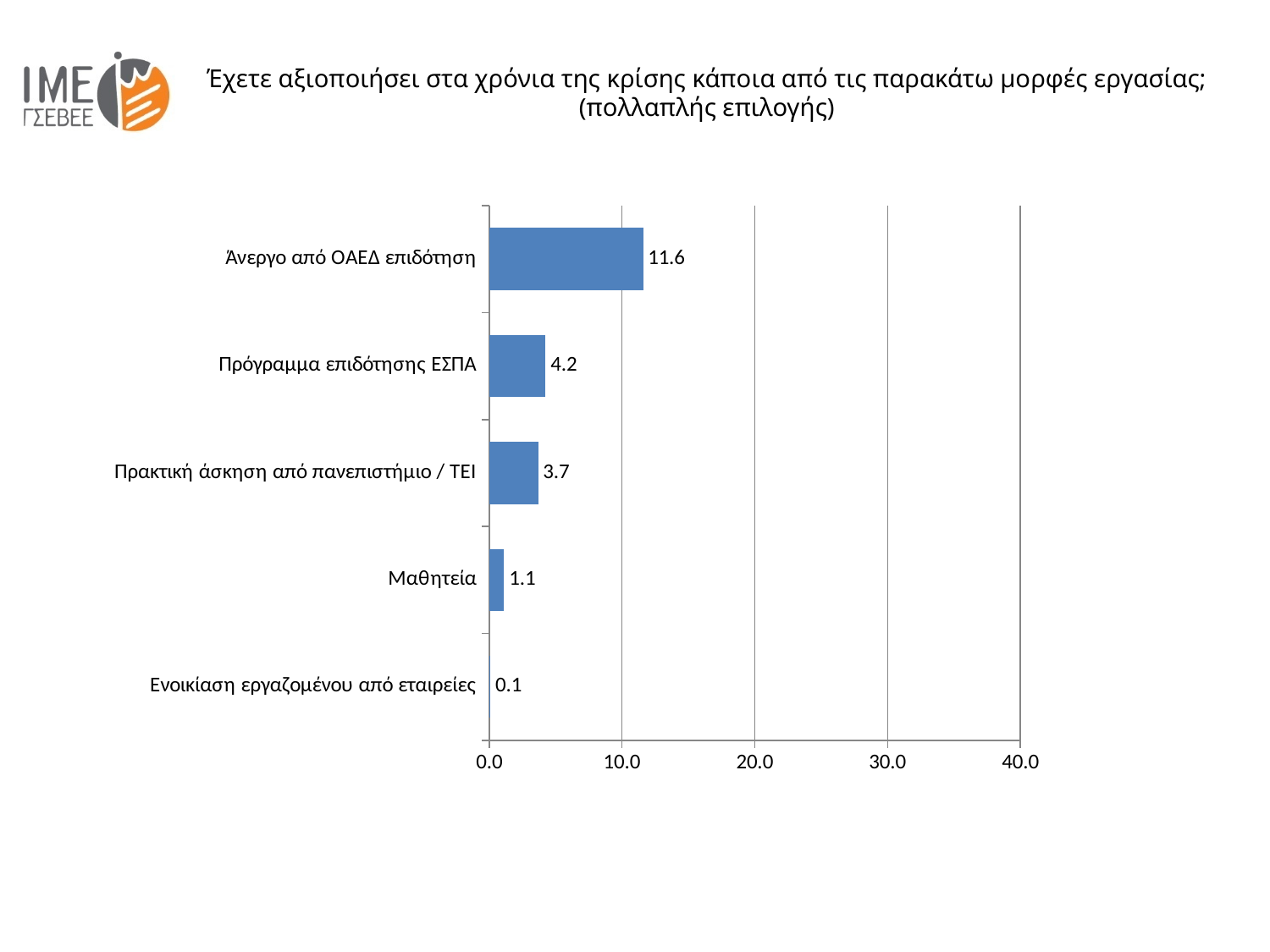
What is the value for Μαθητεία? 1.1 What is the difference between the values for Άνεργο από ΟΑΕΔ επιδότηση and Πρόγραμμα επιδότησης ΕΣΠΑ? 7.4 How many categories are shown in the chart? 5 What is the value for Άνεργο από ΟΑΕΔ επιδότηση? 11.6 What is the value for Ενοικίαση εργαζομένου από εταιρείες? 0.1 Which category has the lowest value? Ενοικίαση εργαζομένου από εταιρείες Which category has the highest value? Άνεργο από ΟΑΕΔ επιδότηση Is the value for Άνεργο από ΟΑΕΔ επιδότηση greater or less than 10.0? greater What is the value for Πρόγραμμα επιδότησης ΕΣΠΑ? 4.2 What is the value for Πρακτική άσκηση από πανεπιστήμιο / ΤΕΙ? 3.7 Which is larger, the value for Πρόγραμμα επιδότησης ΕΣΠΑ or the value for Μαθητεία? Πρόγραμμα επιδότησης ΕΣΠΑ What kind of chart is shown on the slide? bar chart